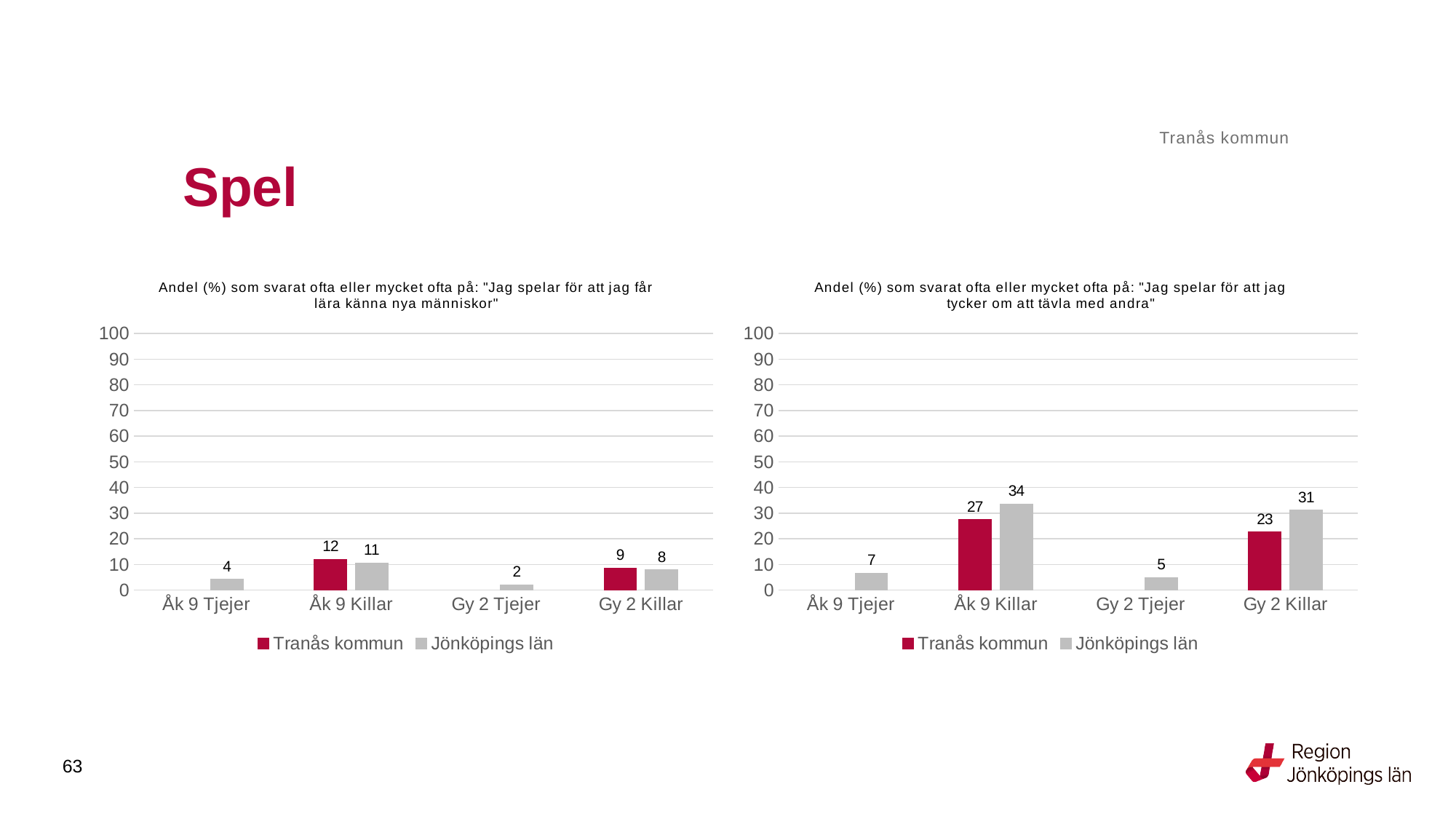
How many series does the legend of the left chart list? 2 In the right chart ("Jag spelar för att jag tycker om att tävla med andra"), which is larger for Gy 2 Killar: Tranås kommun or Jönköpings län? Jönköpings län In the right chart ("Jag spelar för att jag tycker om att tävla med andra"), what is the value for Tranås kommun for Gy 2 Killar? 23 In the left chart ("Jag spelar för att jag får lära känna nya människor"), what is the difference between Tranås kommun and Jönköpings län for Gy 2 Killar? 1 In the right chart ("Jag spelar för att jag tycker om att tävla med andra"), is the value for Jönköpings län for Åk 9 Killar greater or less than 30? greater In the right chart ("Jag spelar för att jag tycker om att tävla med andra"), which category has the highest value for Jönköpings län? Åk 9 Killar In the right chart ("Jag spelar för att jag tycker om att tävla med andra"), what is the value for Jönköpings län for Åk 9 Killar? 34 What kind of chart is the right chart ("Jag spelar för att jag tycker om att tävla med andra")? Bar chart In the right chart ("Jag spelar för att jag tycker om att tävla med andra"), what is the difference between Jönköpings län and Tranås kommun for Åk 9 Killar? 7 In the left chart ("Jag spelar för att jag får lära känna nya människor"), what is the value for Tranås kommun for Åk 9 Killar? 12 In the right chart ("Jag spelar för att jag tycker om att tävla med andra"), which category has the lowest value for Jönköpings län? Gy 2 Tjejer In the left chart ("Jag spelar för att jag får lära känna nya människor"), what is the value for Jönköpings län for Gy 2 Tjejer? 2